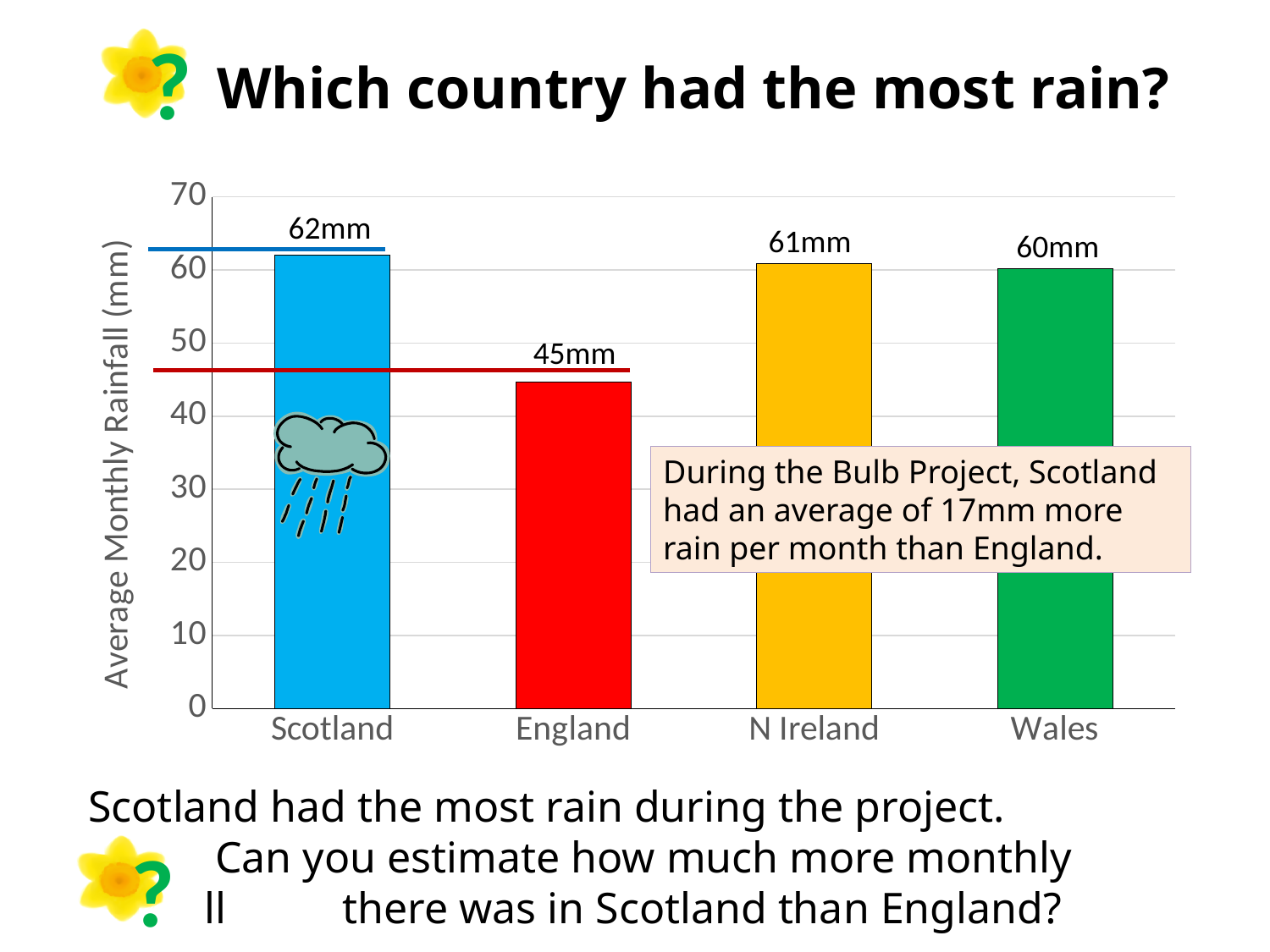
What is the difference in average monthly rainfall between N Ireland and England? 16mm What is the average monthly rainfall for N Ireland? 61mm Which country has the lowest average monthly rainfall? England How much more average monthly rainfall did Scotland have than England? 17mm Which has the higher average monthly rainfall, Wales or England? Wales What is the average monthly rainfall for England? 45mm What is the average monthly rainfall for Scotland? 62mm Is the value for England greater or less than 50? less What is the average monthly rainfall for Wales? 60mm What kind of chart is shown on the slide? Bar chart How many countries are shown on the chart? 4 What is the label on the vertical axis of the chart? Average Monthly Rainfall (mm)